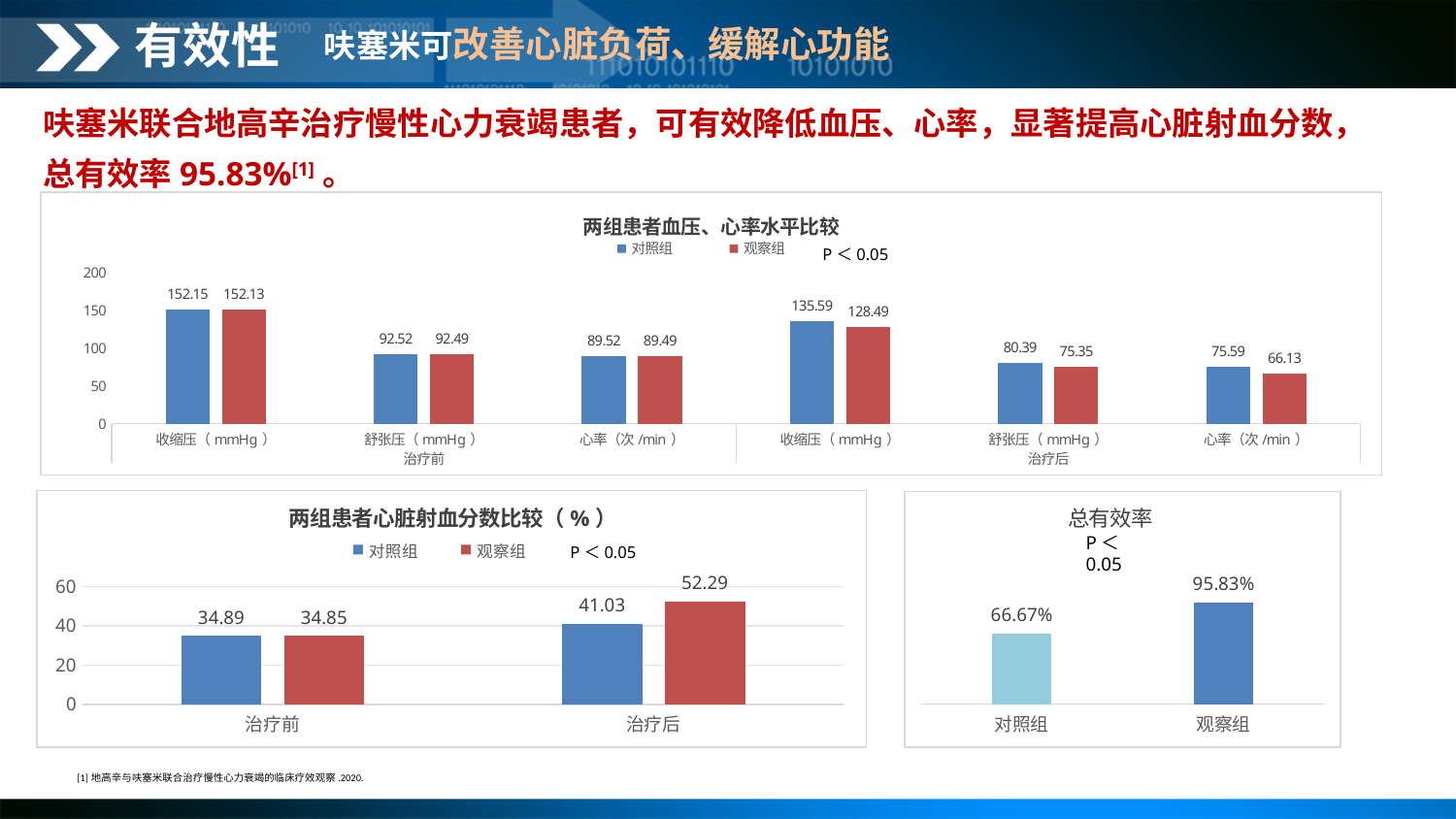
In the chart titled 两组患者血压、心率水平比较, how many series does the legend list? 2 In the chart titled 总有效率, how many categories are shown? 2 In the chart titled 总有效率, what is the value for 对照组? 66.67% In the chart titled 两组患者心脏射血分数比较（%）, what is the difference between 观察组 and 对照组 after treatment (治疗后)? 11.26 In the chart titled 两组患者血压、心率水平比较, which category has the highest value for 对照组? 收缩压 (治疗前) In the chart titled 两组患者心脏射血分数比较（%）, what is the value for 观察组 after treatment (治疗后)? 52.29 In the chart titled 两组患者心脏射血分数比较（%）, what kind of chart is it? Bar chart In the chart titled 两组患者心脏射血分数比较（%）, which is larger after treatment (治疗后): 对照组 or 观察组? 观察组 In the chart titled 两组患者血压、心率水平比较, what is the difference between 对照组 and 观察组 for 心率 after treatment (治疗后)? 9.46 In the chart titled 总有效率, which group has the higher value? 观察组 In the chart titled 两组患者血压、心率水平比较, what is the value for 对照组 for 心率 before treatment (治疗前)? 89.52 In the chart titled 两组患者血压、心率水平比较, what is the value for 观察组 for 收缩压 after treatment (治疗后)? 128.49